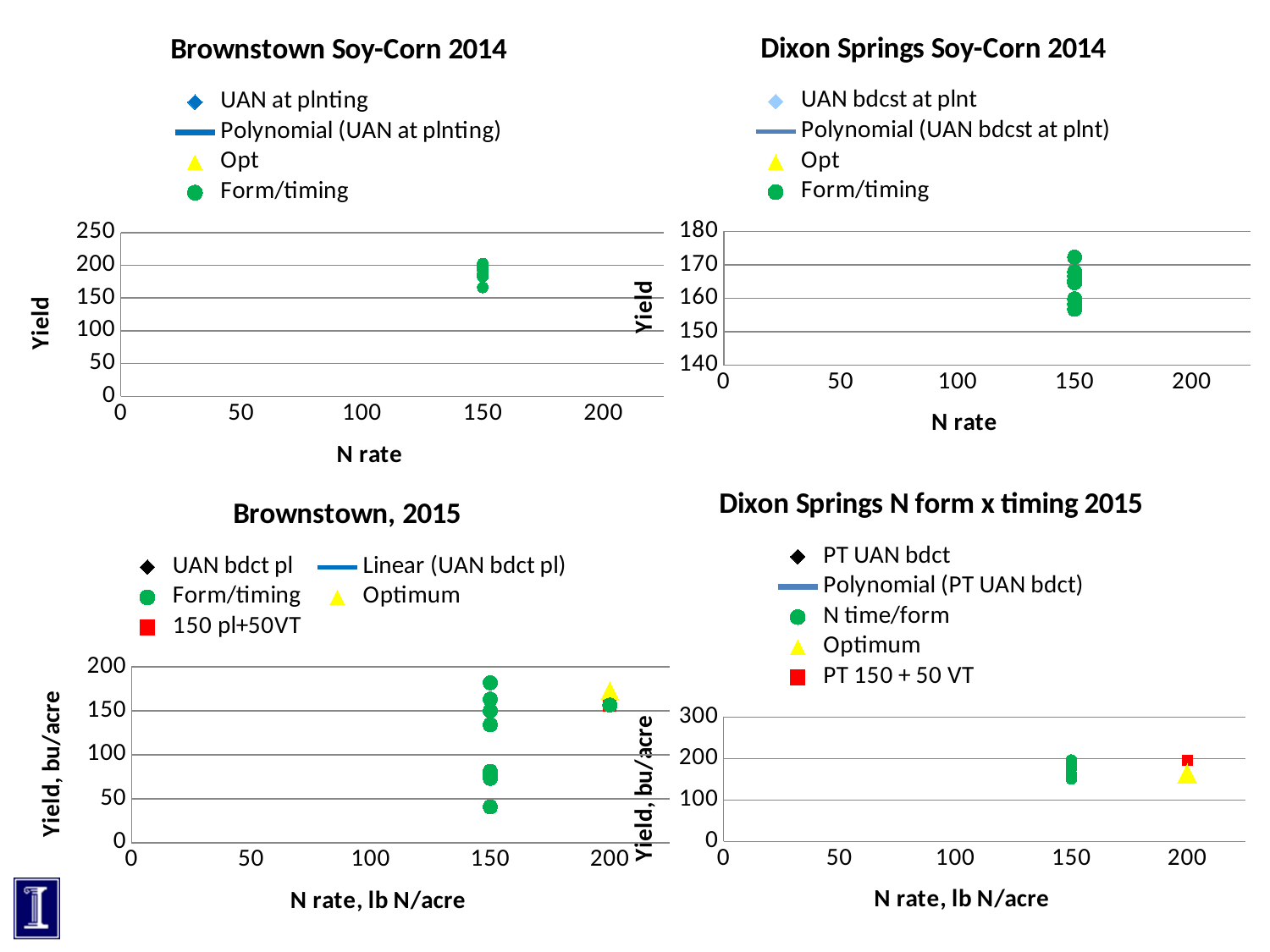
In 'Dixon Springs N form x timing 2015', at N rate 200, which is higher: the 'PT 150 + 50 VT' point or the Optimum point? PT 150 + 50 VT In 'Dixon Springs Soy-Corn 2014', are the Form/timing yield values at N rate 150 greater or less than 180? less How many series does the legend of 'Brownstown Soy-Corn 2014' list? 4 In 'Brownstown Soy-Corn 2014', are the Form/timing yield values at N rate 150 greater or less than 150? greater How many series does the legend of 'Dixon Springs N form x timing 2015' list? 5 In 'Brownstown, 2015', is the yield for the Optimum point at N rate 200 greater or less than 150? greater What is the x-axis label of the 'Brownstown, 2015' chart? N rate, lb N/acre In 'Brownstown, 2015', at N rate 200, which is higher: the Optimum point or the '150 pl+50VT' point? Optimum What kind of chart is 'Brownstown Soy-Corn 2014'? scatter chart